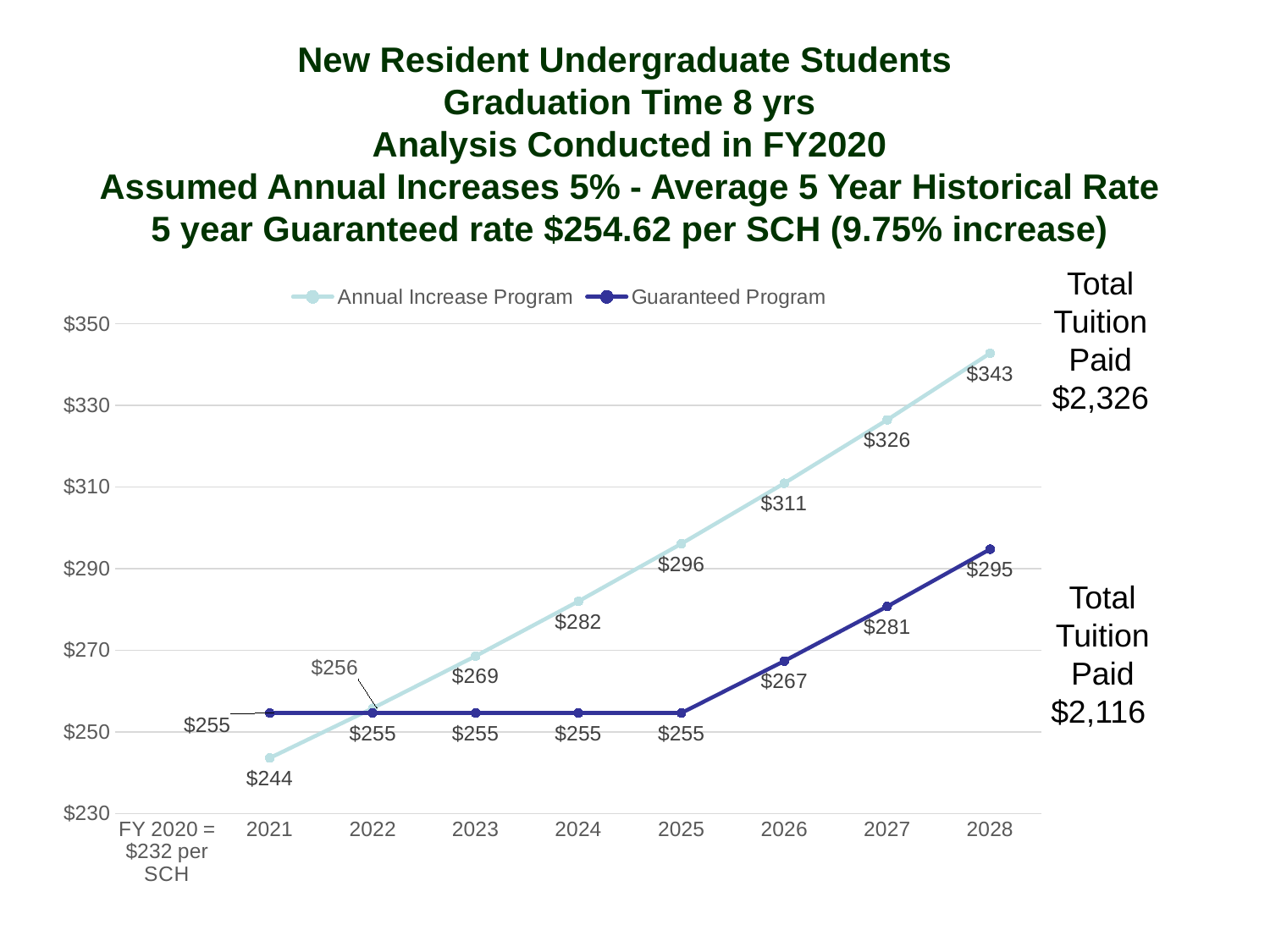
Which series has the larger value in 2021, Annual Increase Program or Guaranteed Program? Guaranteed Program What is the value for the Annual Increase Program in 2028? $343 What is the value for the Annual Increase Program in 2021? $244 What is the difference between the Annual Increase Program and the Guaranteed Program values in 2028? $48 What is the value for the Guaranteed Program in 2026? $267 What kind of chart is shown on the slide? Line chart How many series does the legend list? 2 What is the value for the Guaranteed Program in 2024? $255 Does the Annual Increase Program value rise or fall from 2021 to 2028? Rise Is the Annual Increase Program value in 2026 greater or less than $310? greater In which year is the Guaranteed Program value highest? 2028 In which year is the Annual Increase Program value lowest? 2021